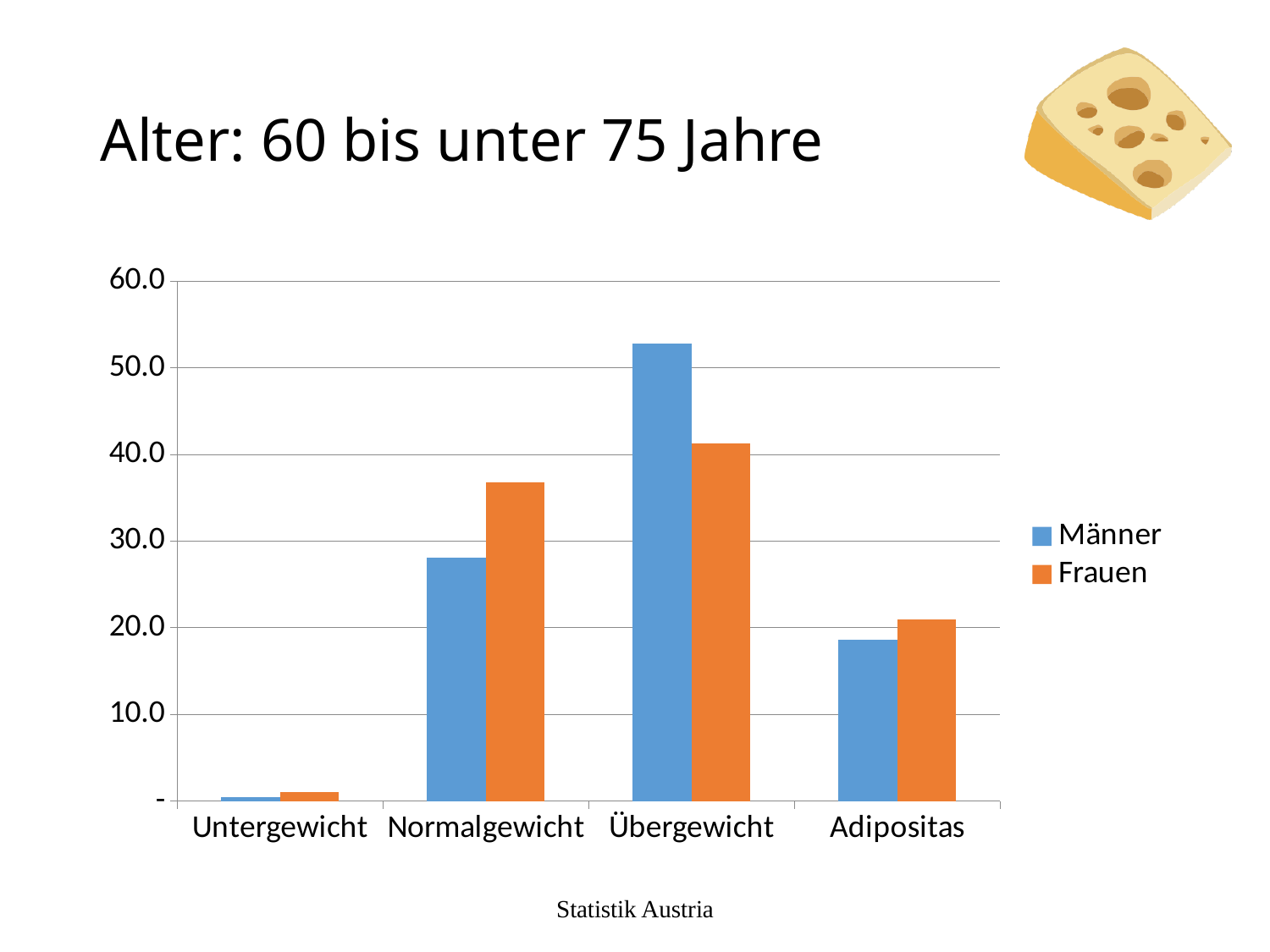
In Übergewicht, which series has the larger value, Männer or Frauen? Männer Which category has the highest value for Männer? Übergewicht What kind of chart is shown on the slide? bar chart In Normalgewicht, which series has the larger value, Männer or Frauen? Frauen Is the value for Männer in Adipositas greater or less than 20? less How many series does the legend list? 2 Which category has the lowest value for Männer? Untergewicht Is the value for Männer in Übergewicht greater or less than 50? greater Which category has the highest value for Frauen? Übergewicht Is the value for Frauen in Normalgewicht greater or less than 30? greater How many categories are shown on the x axis? 4